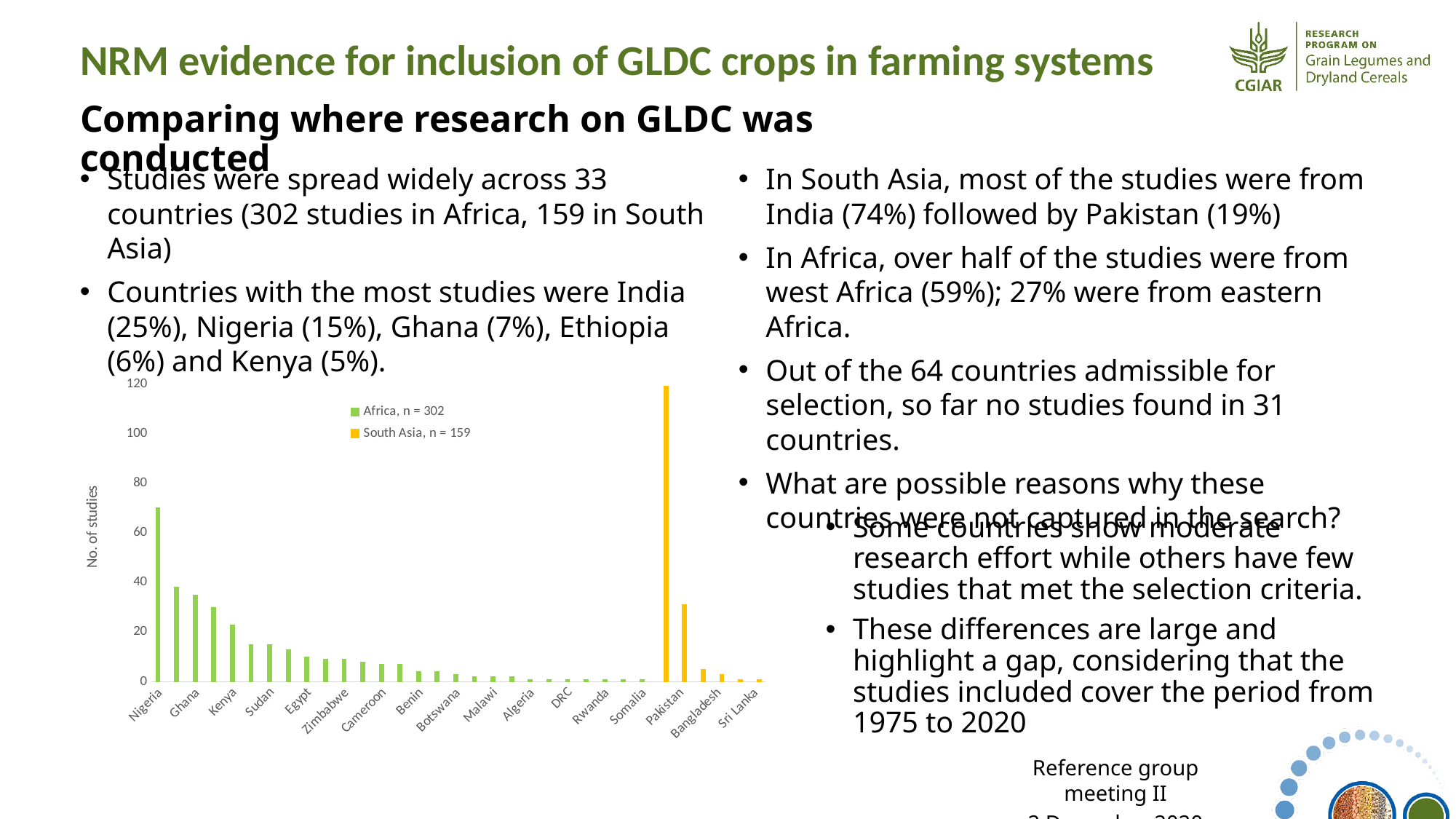
Is the value for Pakistan greater or less than 60? less What are the two series named in the chart legend? Africa, n = 302 and South Asia, n = 159 Do the Africa bars rise or fall from left to right along the x axis? fall Is the value for Sri Lanka greater or less than 20? less Is the value for Nigeria greater or less than 60? greater Which has more studies, Nigeria or Ghana? Nigeria Which has more studies, Nigeria or Pakistan? Nigeria What kind of chart is shown on the slide? bar chart What is the title of the chart's vertical axis? No. of studies How many series does the chart legend list? 2 Which series contains the tallest bar in the chart? South Asia, n = 159